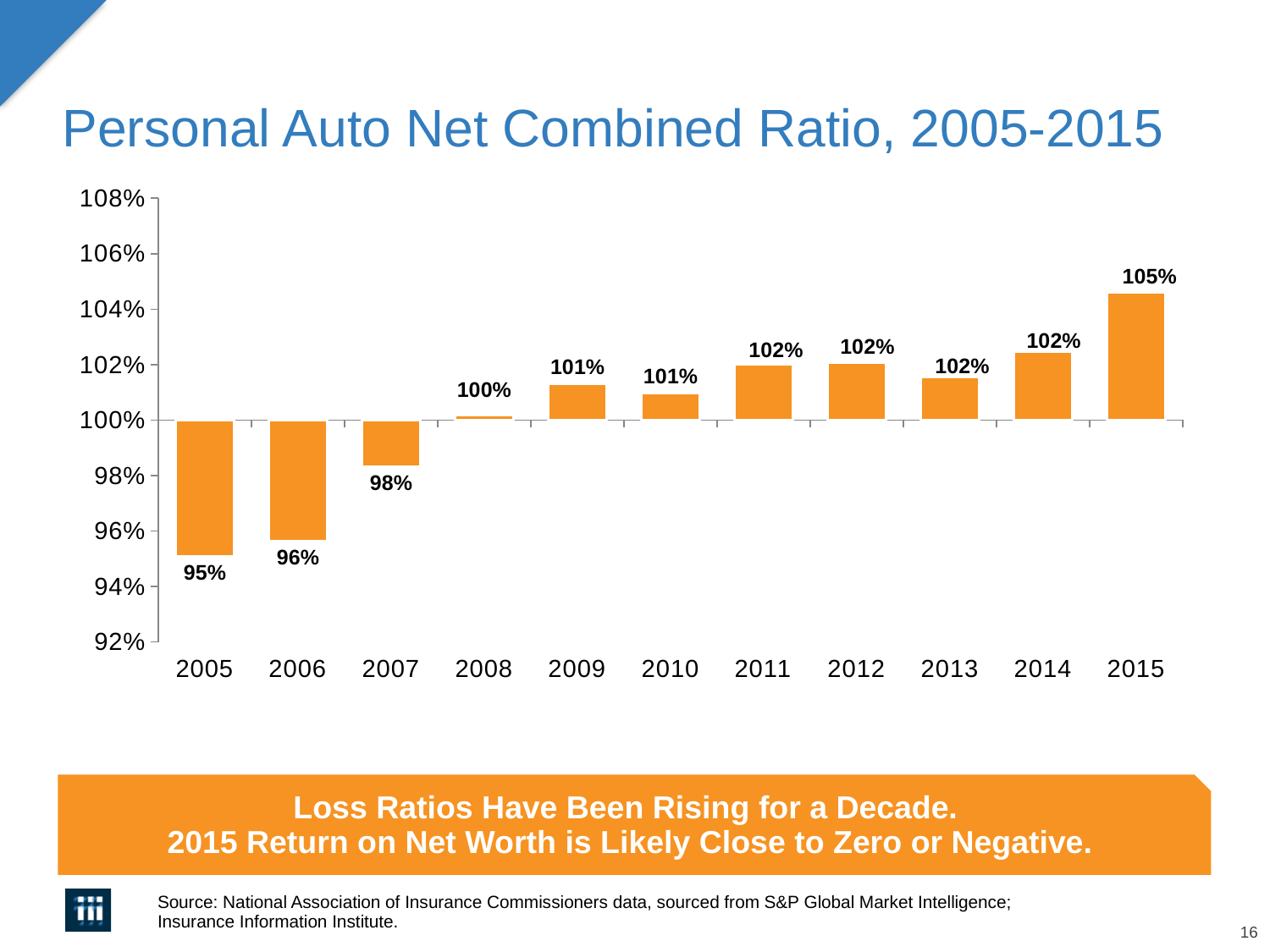
Which year has the highest personal auto net combined ratio? 2015 What is the personal auto net combined ratio for 2015? 105% Does the personal auto net combined ratio generally rise or fall from 2005 to 2015? Rise Which year has the larger combined ratio, 2006 or 2014? 2014 Is the combined ratio for 2007 greater or less than 100%? less What kind of chart is used to show the personal auto net combined ratio? Bar chart What is the personal auto net combined ratio for 2008? 100% Which year has the lowest personal auto net combined ratio? 2005 How many years are shown on the x axis of the chart? 11 What is the personal auto net combined ratio for 2005? 95% What is the personal auto net combined ratio for 2007? 98% By how many percentage points does the 2015 combined ratio exceed the 2005 combined ratio? 10 percentage points